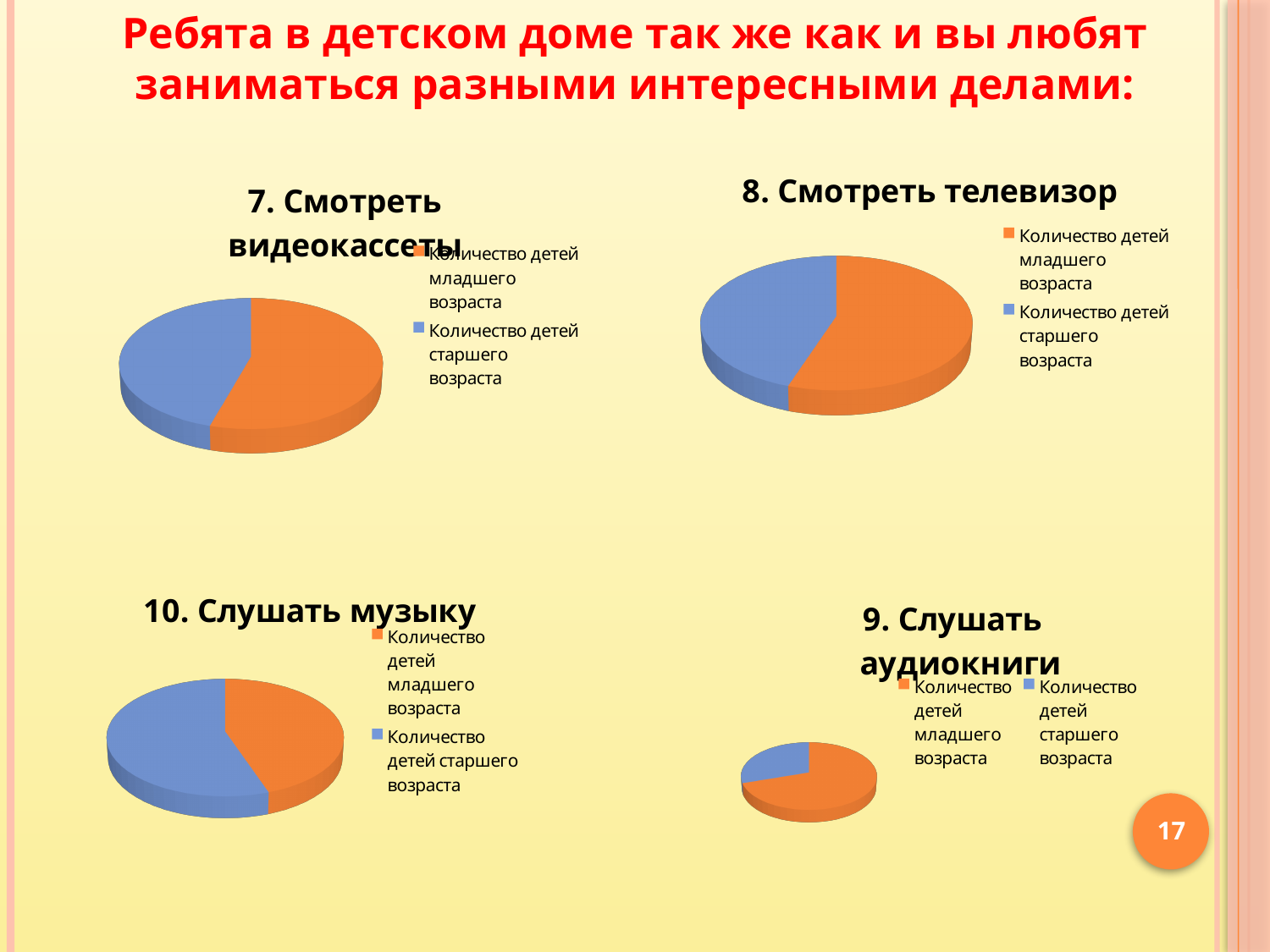
What colour represents Количество детей старшего возраста in the chart "7. Смотреть видеокассеты"? blue In the chart "8. Смотреть телевизор", which slice is larger: Количество детей младшего возраста or Количество детей старшего возраста? Количество детей младшего возраста In the chart "9. Слушать аудиокниги", which slice is larger: Количество детей младшего возраста or Количество детей старшего возраста? Количество детей младшего возраста How many charts are shown on the slide? 4 In the chart "10. Слушать музыку", which slice is larger: Количество детей младшего возраста or Количество детей старшего возраста? Количество детей старшего возраста In the chart "10. Слушать музыку", how many slices does the pie have? 2 What kind of chart is used for "8. Смотреть телевизор"? pie chart In the chart "9. Слушать аудиокниги", how many entries does the legend list? 2 In the chart "10. Слушать музыку", which category has the largest slice? Количество детей старшего возраста What is the title of the chart in the top-left of the slide? 7. Смотреть видеокассеты In the chart "9. Слушать аудиокниги", which category has the smallest slice? Количество детей старшего возраста